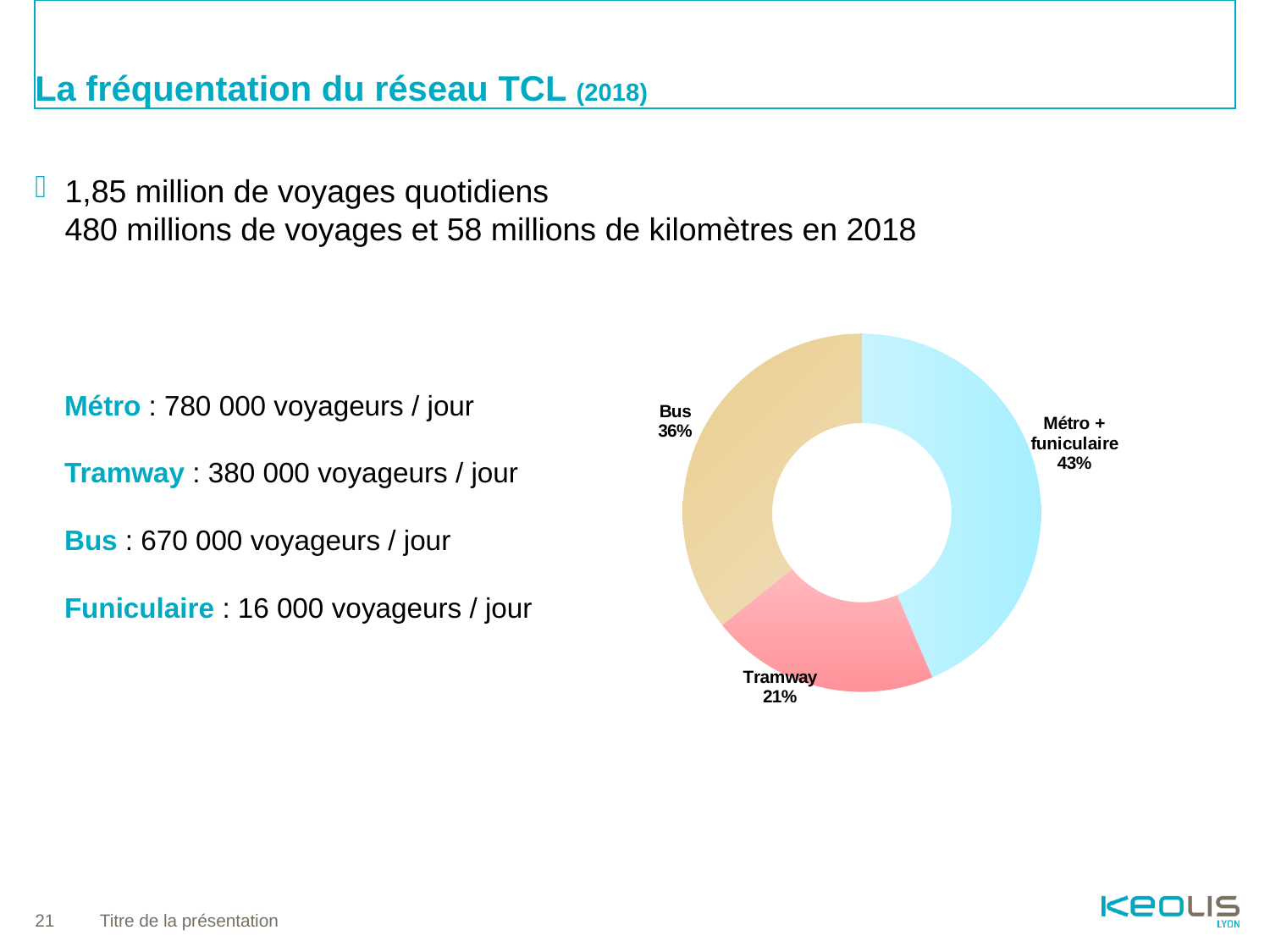
What colour is the Bus slice in the doughnut chart? Beige What share of the doughnut chart does Tramway represent? 21% Which is larger in the doughnut chart, the Bus share or the Tramway share? Bus What share of the doughnut chart does Bus represent? 36% What share of the doughnut chart does Métro + funiculaire represent? 43% What is the difference in percentage points between the Métro + funiculaire share and the Bus share? 7 percentage points What is the difference in percentage points between the Bus share and the Tramway share? 15 percentage points What colour is the Tramway slice in the doughnut chart? Pink Which category has the largest share in the doughnut chart? Métro + funiculaire What kind of chart is shown on the slide? Doughnut chart Which category has the smallest share in the doughnut chart? Tramway How many categories are shown in the doughnut chart? 3